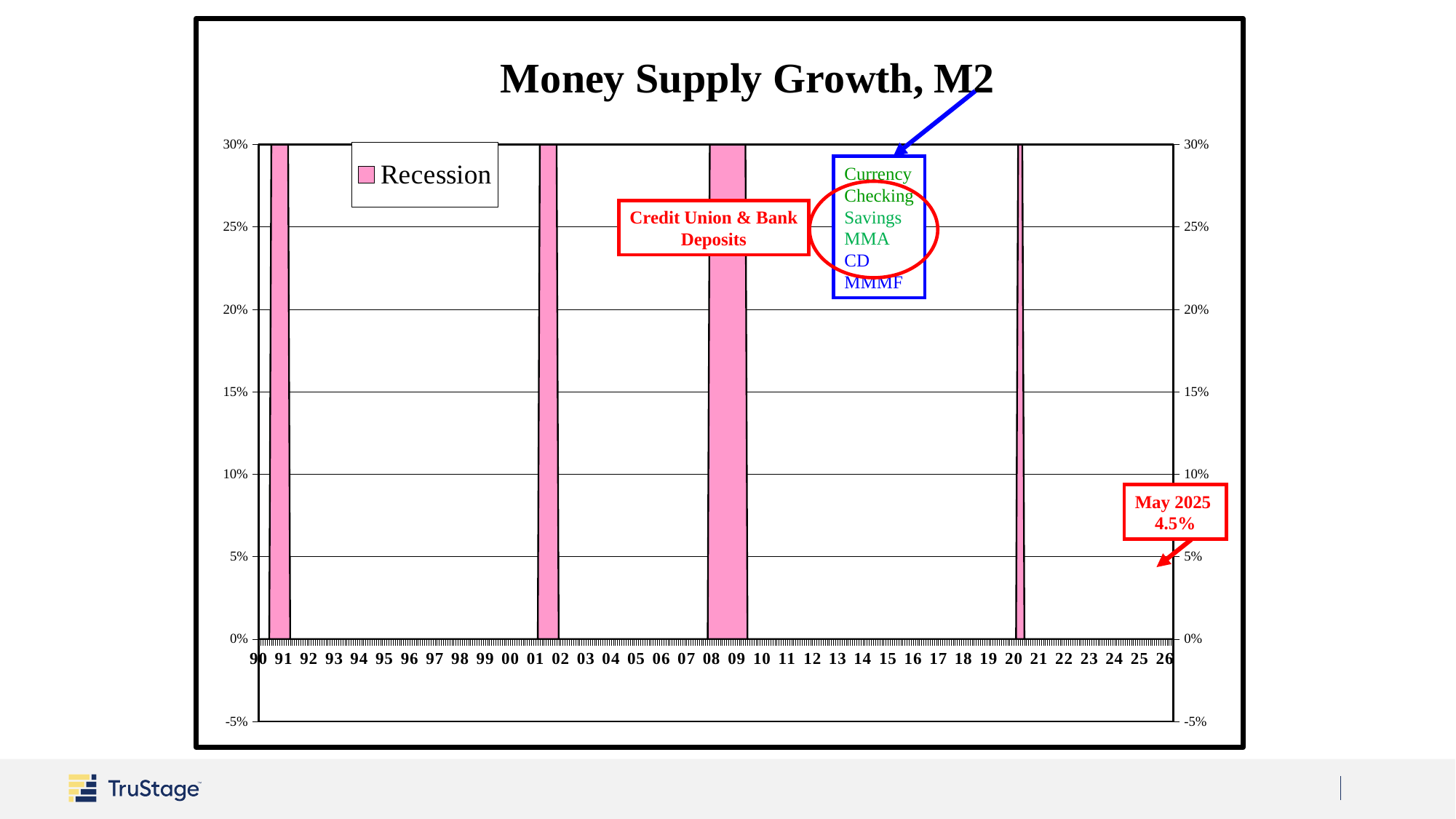
What value does the chart annotate for May 2025? 4.5% What is the highest value shown on the chart's vertical axis? 30% How many shaded recession periods are shown on the chart? 4 Is the annotated May 2025 value greater or less than 5%? less What is the title of the chart? Money Supply Growth, M2 What is the last year label on the chart's horizontal axis? 26 How many entries does the chart's legend list? 1 What is the lowest value shown on the chart's vertical axis? -5% What does the pink shading on the chart represent, according to the legend? Recession What is the first year label on the chart's horizontal axis? 90 Is the annotated May 2025 value greater or less than 0%? greater